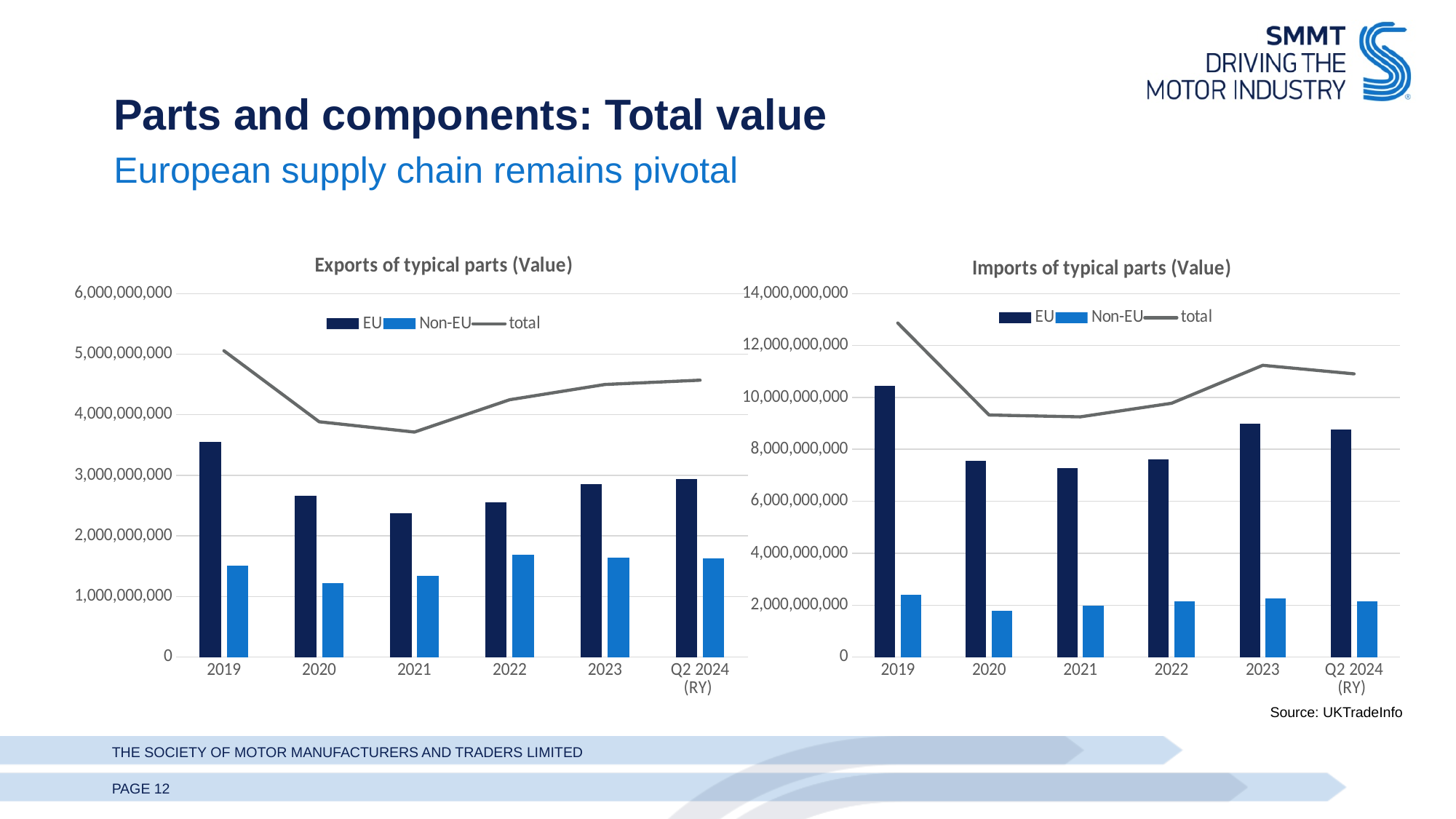
In the Exports of typical parts (Value) chart, is the EU value for 2019 greater or less than 3,000,000,000? greater How many periods are shown on the x axis of the Exports of typical parts (Value) chart? 6 In the Imports of typical parts (Value) chart, which year has the highest EU bar? 2019 In the Exports of typical parts (Value) chart, does the total line rise or fall from 2021 to Q2 2024 (RY)? rises In the Imports of typical parts (Value) chart, is the total for 2019 greater or less than 12,000,000,000? greater In the Exports of typical parts (Value) chart, is the Non-EU value for 2022 greater or less than 2,000,000,000? less In the Imports of typical parts (Value) chart, which year has the lowest Non-EU bar? 2020 In the Exports of typical parts (Value) chart, which year has the lowest EU bar? 2021 How many series does the legend of the Imports of typical parts (Value) chart list? 3 In the Exports of typical parts (Value) chart, which year has the highest EU bar? 2019 In the Imports of typical parts (Value) chart, which is larger, the EU value for 2023 or for Q2 2024 (RY)? 2023